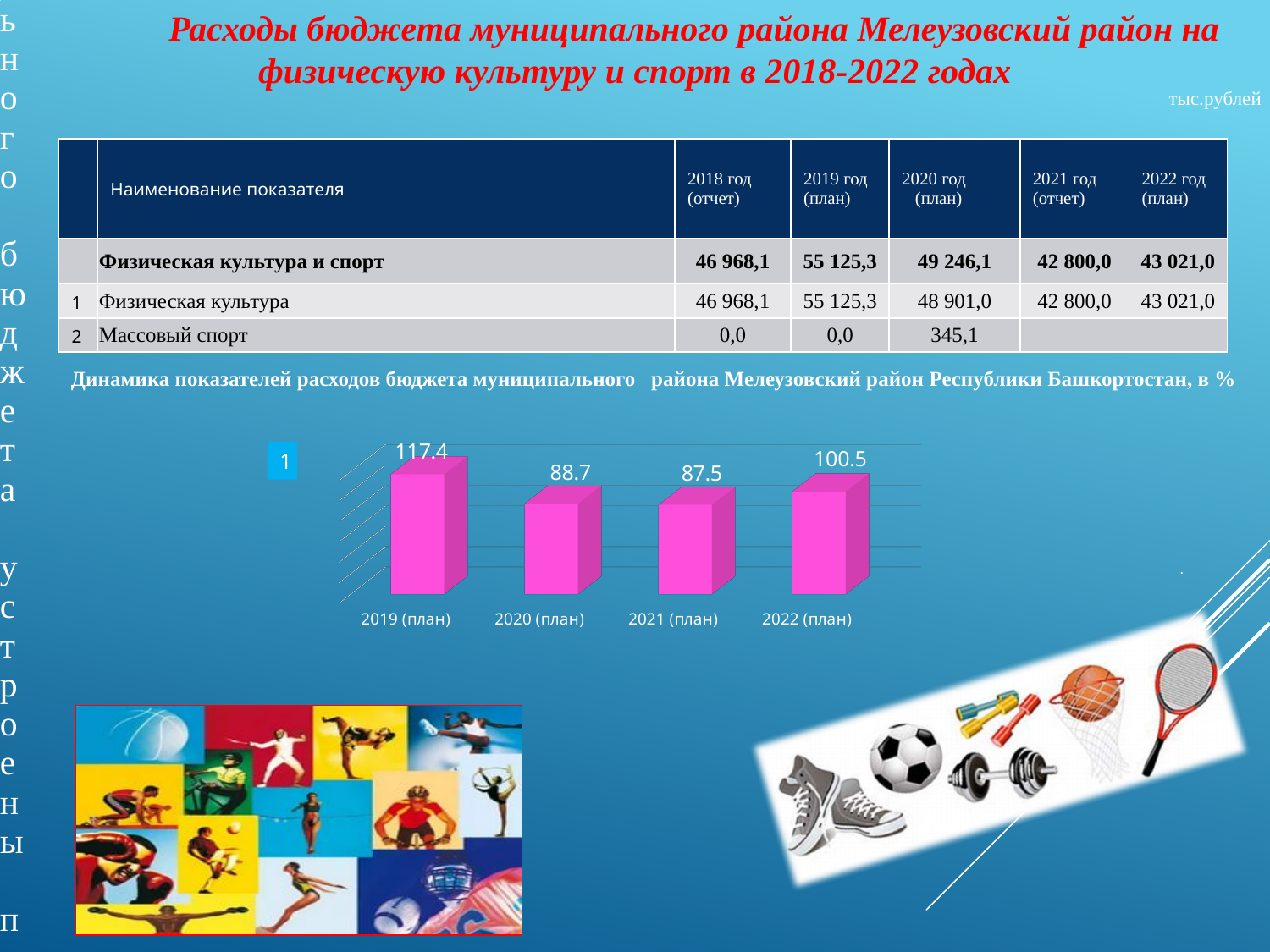
What is the difference between the values for 2022 (план) and 2021 (план)? 13.0 How many categories are plotted in the chart? 4 What is the value shown for 2019 (план) in the chart? 117.4 Which category has the lowest value in the chart? 2021 (план) What kind of chart is shown on the slide? bar chart Which category has the highest value in the chart? 2019 (план) Do the values rise or fall from 2019 (план) to 2021 (план)? fall What colour are the bars in the chart? pink What is the difference between the values for 2019 (план) and 2020 (план)? 28.7 What is the value shown for 2022 (план) in the chart? 100.5 What is the value shown for 2021 (план) in the chart? 87.5 Which is larger, the value for 2020 (план) or the value for 2022 (план)? 2022 (план)